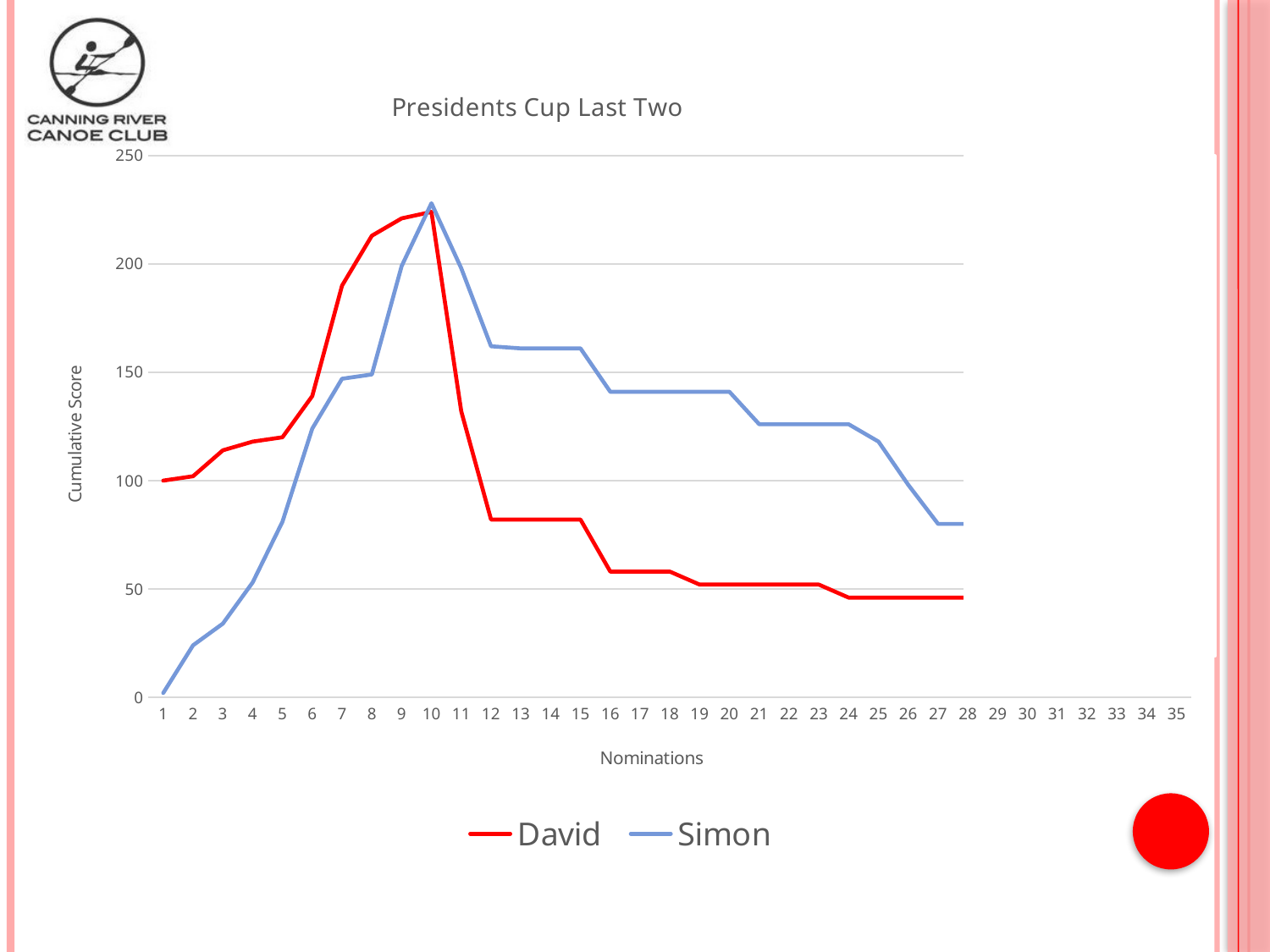
At nomination 5, which series has the higher cumulative score, David or Simon? David Is Simon's value at nomination 16 greater or less than 150? less What is the label of the vertical axis? Cumulative Score At nomination 20, which series has the higher cumulative score, David or Simon? Simon Is David's value at nomination 12 greater or less than 100? less What is David's cumulative score at nomination 1? 100 What kind of chart is shown on the slide? line chart Does David's cumulative score rise or fall from nomination 12 to nomination 28? fall How many series does the legend list? 2 What is the title of the chart? Presidents Cup Last Two Is David's value at nomination 8 greater or less than 200? greater